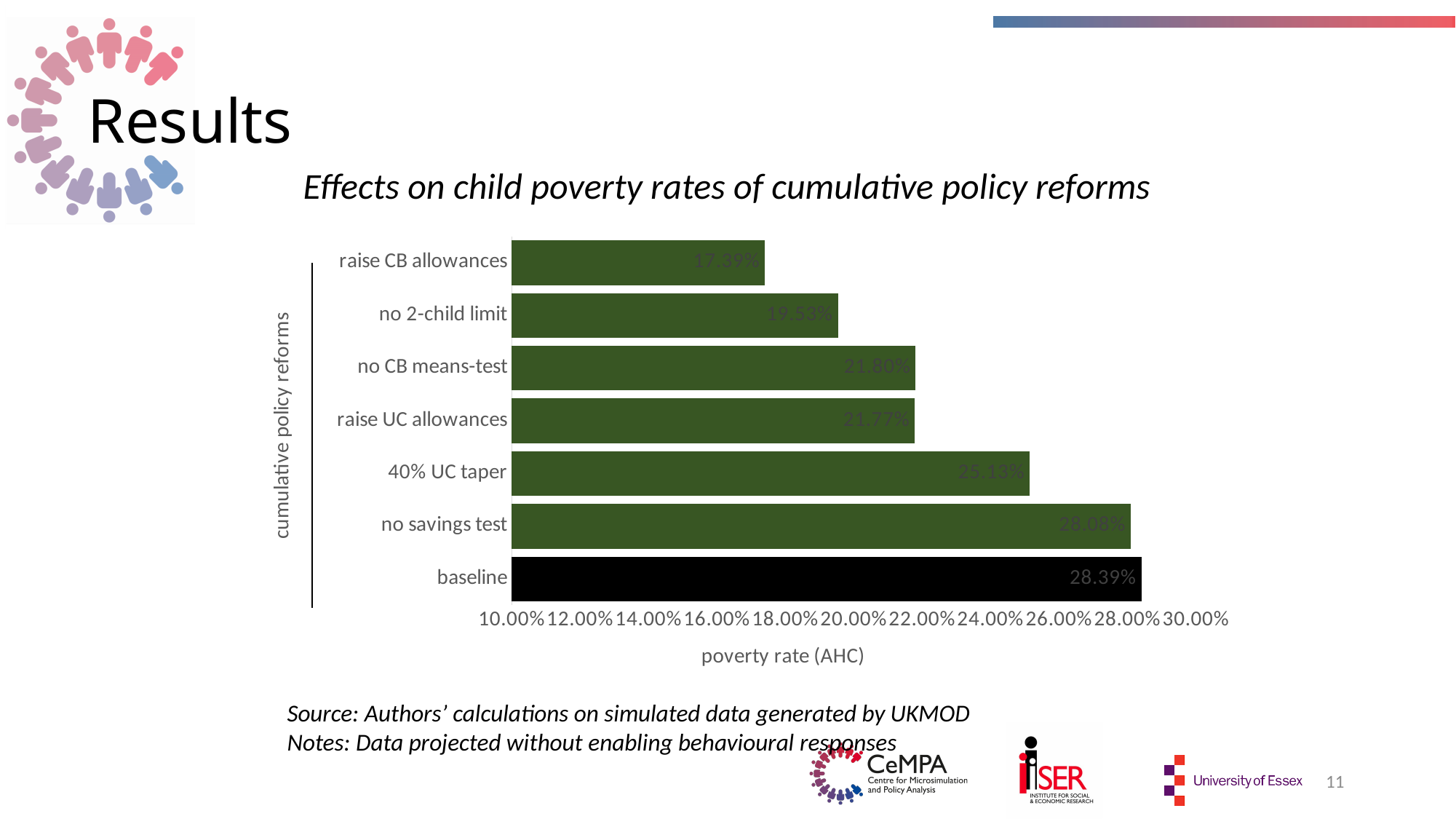
How many categories are shown on the chart? 7 Is the poverty rate for 'no CB means-test' greater or less than 20.00%? greater What is the poverty rate (AHC) for '40% UC taper'? 25.13% What is the difference in poverty rate between the baseline and 'raise CB allowances'? 11.00% What is the poverty rate (AHC) for 'raise CB allowances'? 17.39% What is the poverty rate (AHC) for 'no 2-child limit'? 19.53% What is the title of the chart? Effects on child poverty rates of cumulative policy reforms Which has a higher poverty rate: 'no savings test' or '40% UC taper'? no savings test Which cumulative policy reform has the lowest poverty rate? raise CB allowances What type of chart is shown on the slide? bar chart What is the poverty rate (AHC) for the baseline? 28.39% Which category has the highest poverty rate? baseline